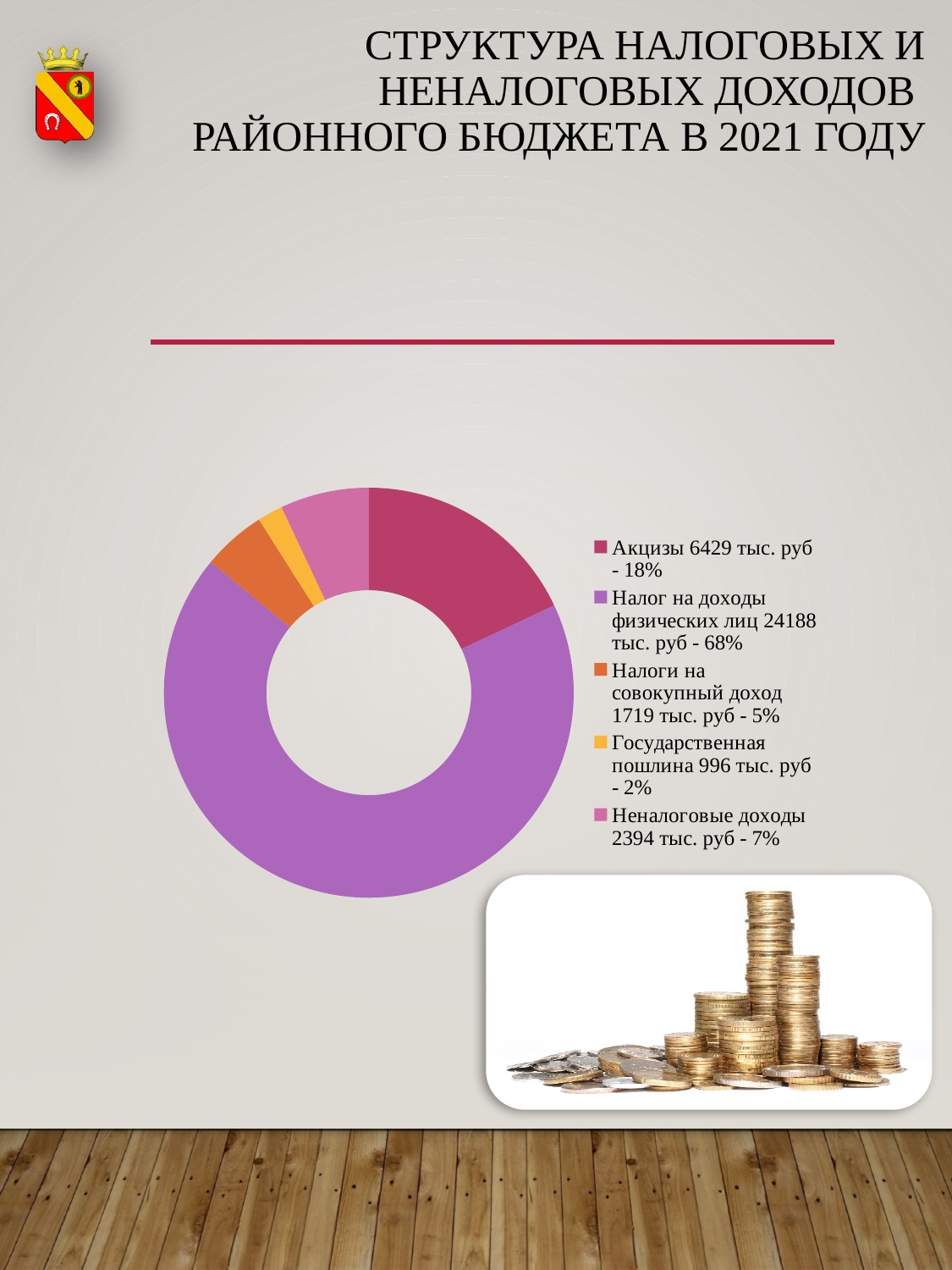
What share of the chart does Налоги на совокупный доход represent? 5% What is the difference between the values for Налог на доходы физических лиц and Акцизы? 17759 тыс. руб What is the value for Налог на доходы физических лиц? 24188 тыс. руб Which category has the smallest share of the chart? Государственная пошлина Which is larger, the value for Неналоговые доходы or the value for Налоги на совокупный доход? Неналоговые доходы What colour is the slice for Государственная пошлина? yellow What is the value for Акцизы? 6429 тыс. руб Which category has the largest share of the chart? Налог на доходы физических лиц What kind of chart is shown on the slide? doughnut chart What is the value for Государственная пошлина? 996 тыс. руб What share of the chart does Неналоговые доходы represent? 7% How many categories does the chart show? 5